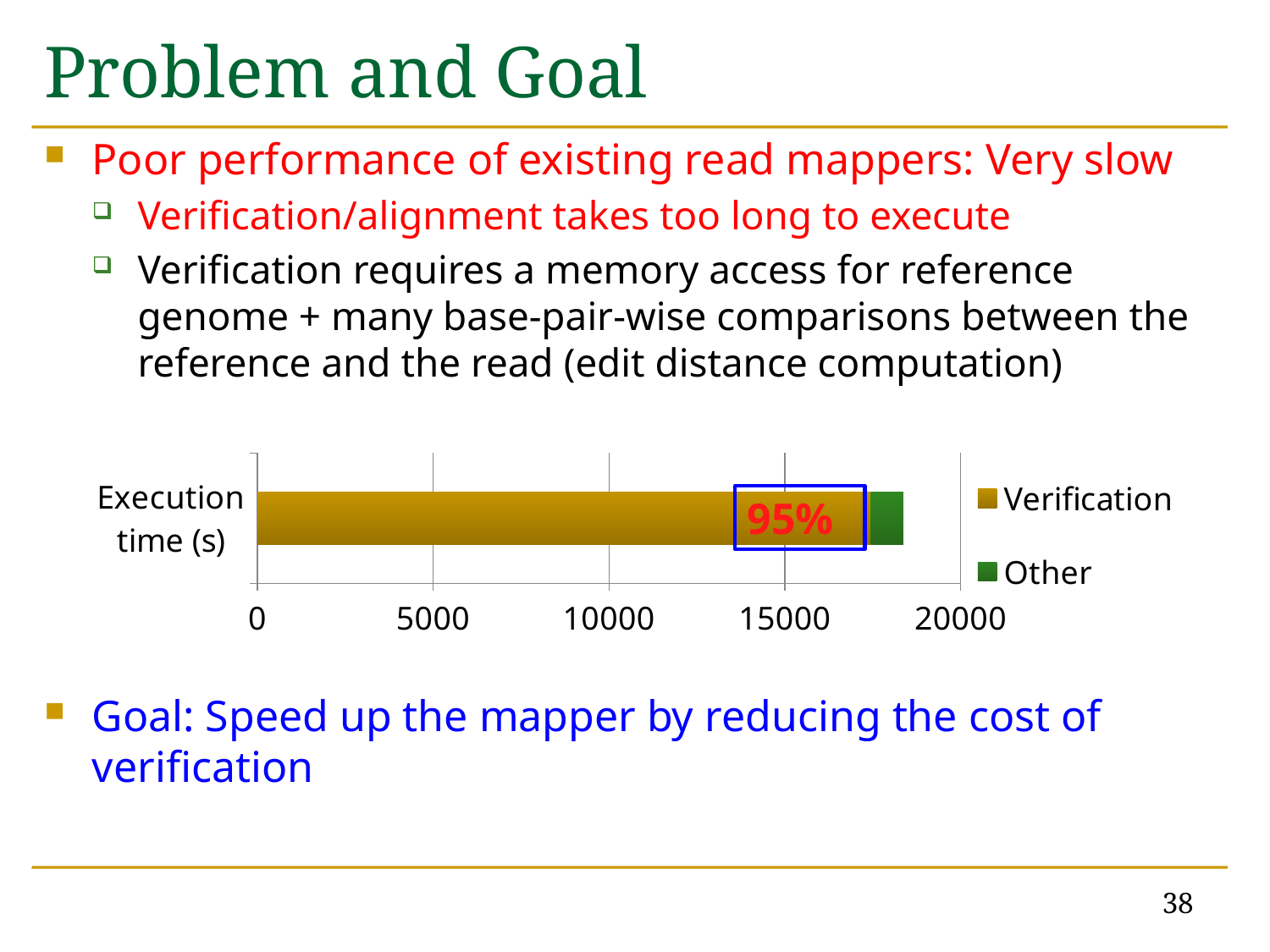
Is the total length of the Execution time bar greater or less than 20000? less What is the highest tick value shown on the chart's horizontal axis? 20000 Is the Verification portion of the Execution time bar greater or less than 10000? greater What is the label of the category plotted in the chart? Execution time (s) How many categories are plotted on the chart's vertical axis? 1 What percentage is printed on the Verification portion of the bar? 95% How many series does the chart's legend list? 2 Is the Verification portion of the Execution time bar greater or less than 15000? greater Which series takes up the larger portion of the Execution time bar, Verification or Other? Verification What kind of chart is shown on the slide? bar chart Which series has the smallest share of the Execution time bar? Other What are the two series named in the chart's legend? Verification and Other